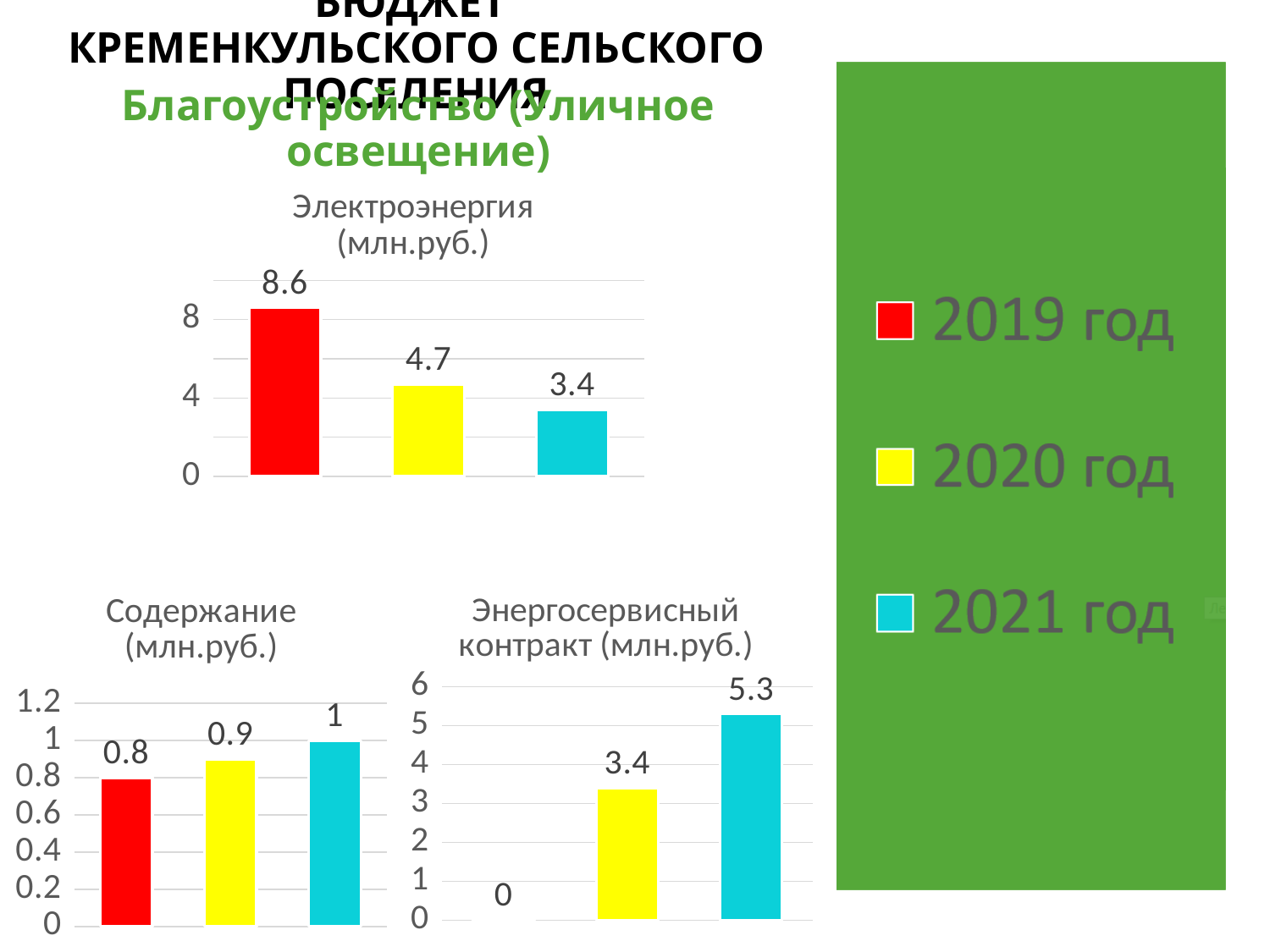
In the chart titled 'Электроэнергия (млн.руб.)', which year has the highest value? 2019 год In the chart titled 'Электроэнергия (млн.руб.)', what is the value for 2021 год? 3.4 How many entries does the legend on the slide list? 3 In the chart titled 'Содержание (млн.руб.)', which year has the lowest value? 2019 год In the chart titled 'Электроэнергия (млн.руб.)', what is the difference between the 2019 год and 2020 год values? 3.9 In the chart titled 'Содержание (млн.руб.)', what is the value for 2020 год? 0.9 In the chart titled 'Содержание (млн.руб.)', do the values rise or fall from 2019 to 2021? rise In the chart titled 'Электроэнергия (млн.руб.)', what is the value for 2019 год? 8.6 In the chart titled 'Энергосервисный контракт (млн.руб.)', what is the difference between the 2021 год and 2020 год values? 1.9 In the chart titled 'Энергосервисный контракт (млн.руб.)', what is the value for 2019 год? 0 In the chart titled 'Энергосервисный контракт (млн.руб.)', what is the value for 2021 год? 5.3 In the chart titled 'Электроэнергия (млн.руб.)', do the values rise or fall from 2019 to 2021? fall